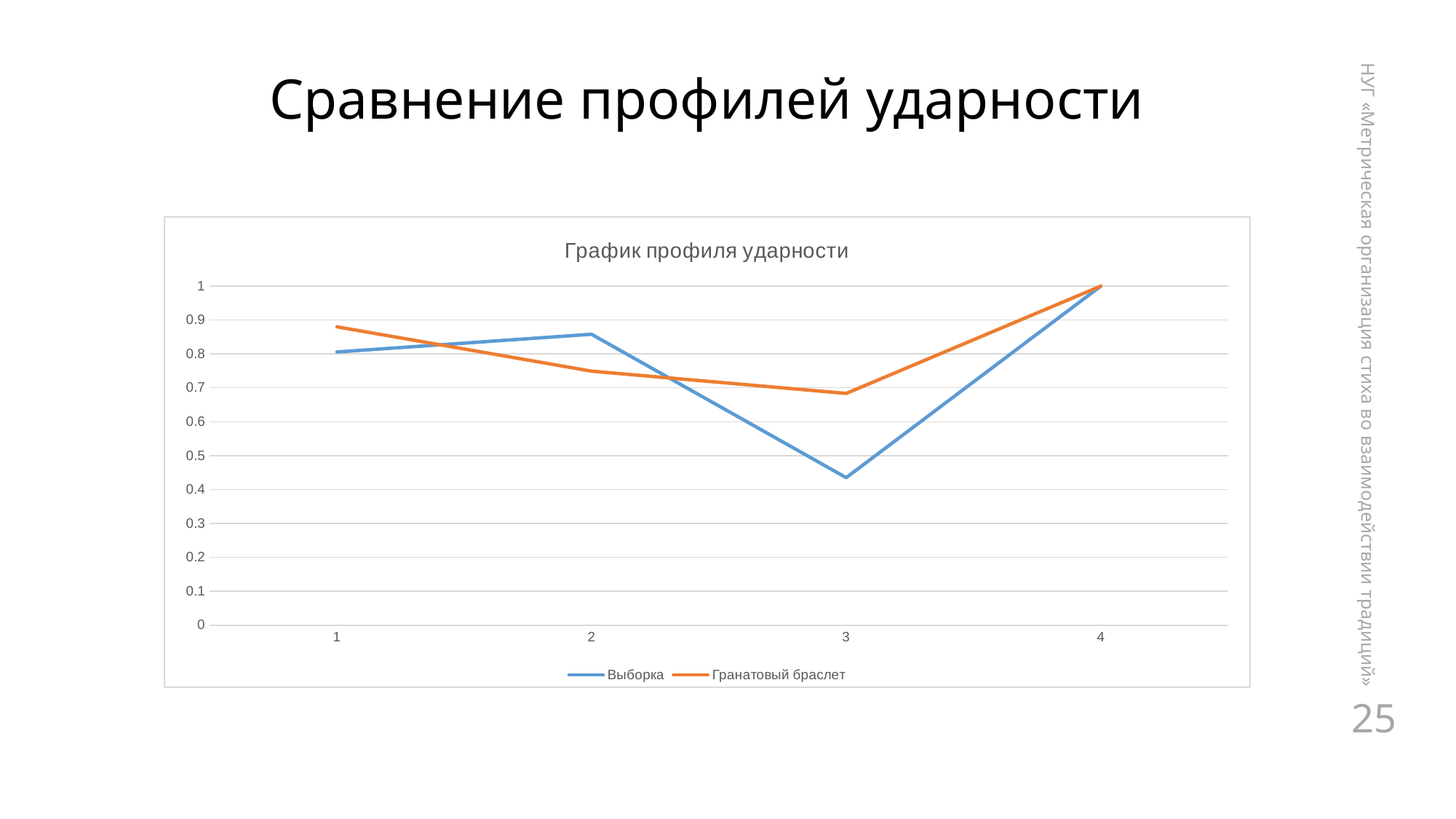
What is the title of the chart? График профиля ударности At x = 1, which series has the larger value, Выборка or Гранатовый браслет? Гранатовый браслет At x = 3, which series has the larger value, Выборка or Гранатовый браслет? Гранатовый браслет What is the value of Гранатовый браслет at x = 4? 1 What is the value of Выборка at x = 4? 1 Is the value for Выборка at x = 3 greater or less than 0.5? less How many points are plotted along the x axis for each series? 4 Is the value for Гранатовый браслет at x = 2 greater or less than 0.7? greater What kind of chart is shown on the slide? line chart At which x value is Выборка lowest? 3 At which x value is Гранатовый браслет lowest? 3 How many series does the legend list? 2